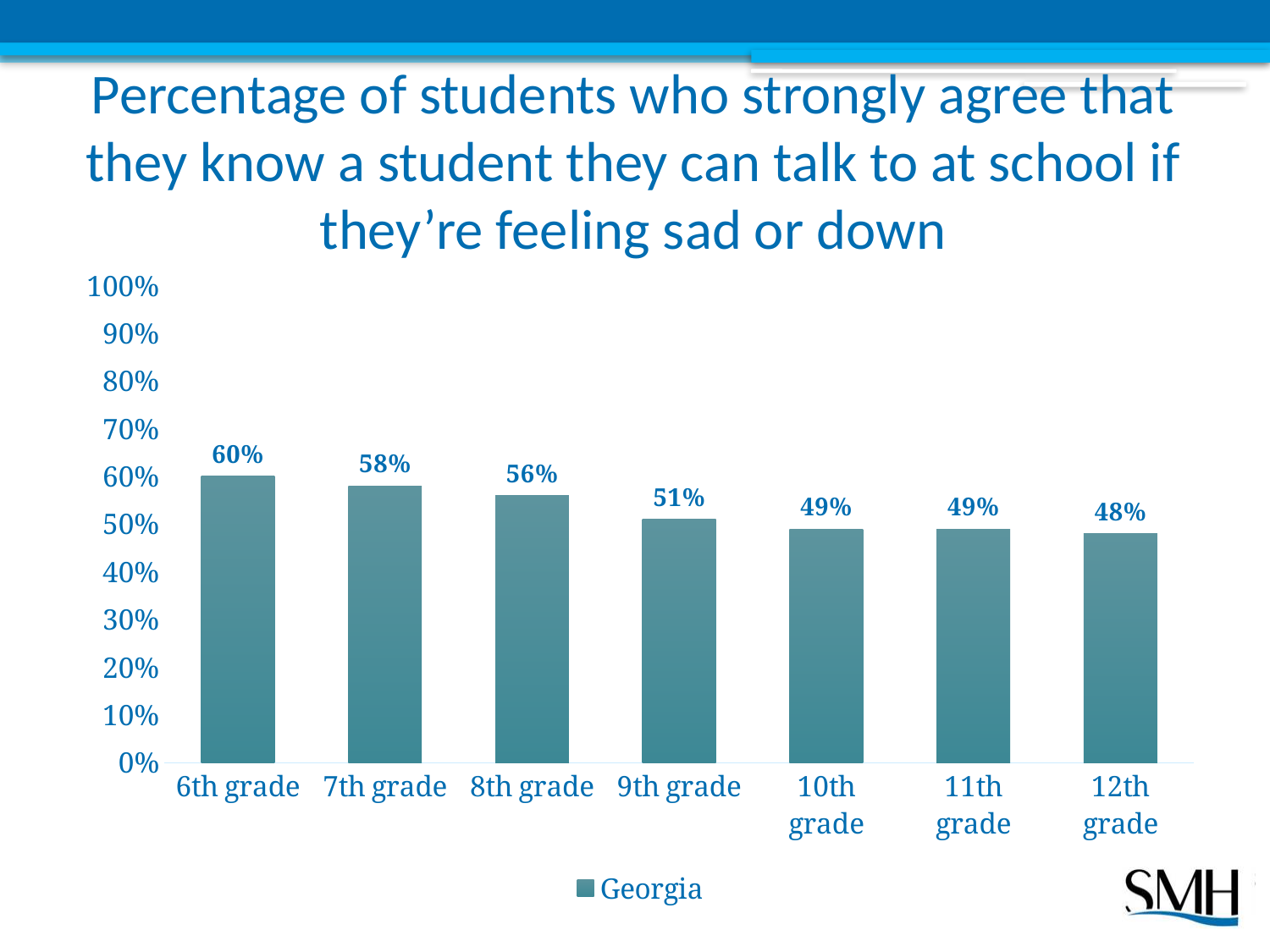
What is the value for 9th grade? 51% Which grade has the highest percentage? 6th grade Which grade has the lowest percentage? 12th grade Is the value for 11th grade greater or less than 60%? less Which is larger, the value for 8th grade or the value for 10th grade? 8th grade What is the difference between the values for 7th grade and 9th grade? 7% What kind of chart is shown on the slide? bar chart Do the values rise or fall from 6th grade to 12th grade? fall How many grade categories are shown on the x axis? 7 What is the value for 6th grade? 60% What is the value for 12th grade? 48% What is the difference between the values for 6th grade and 12th grade? 12%